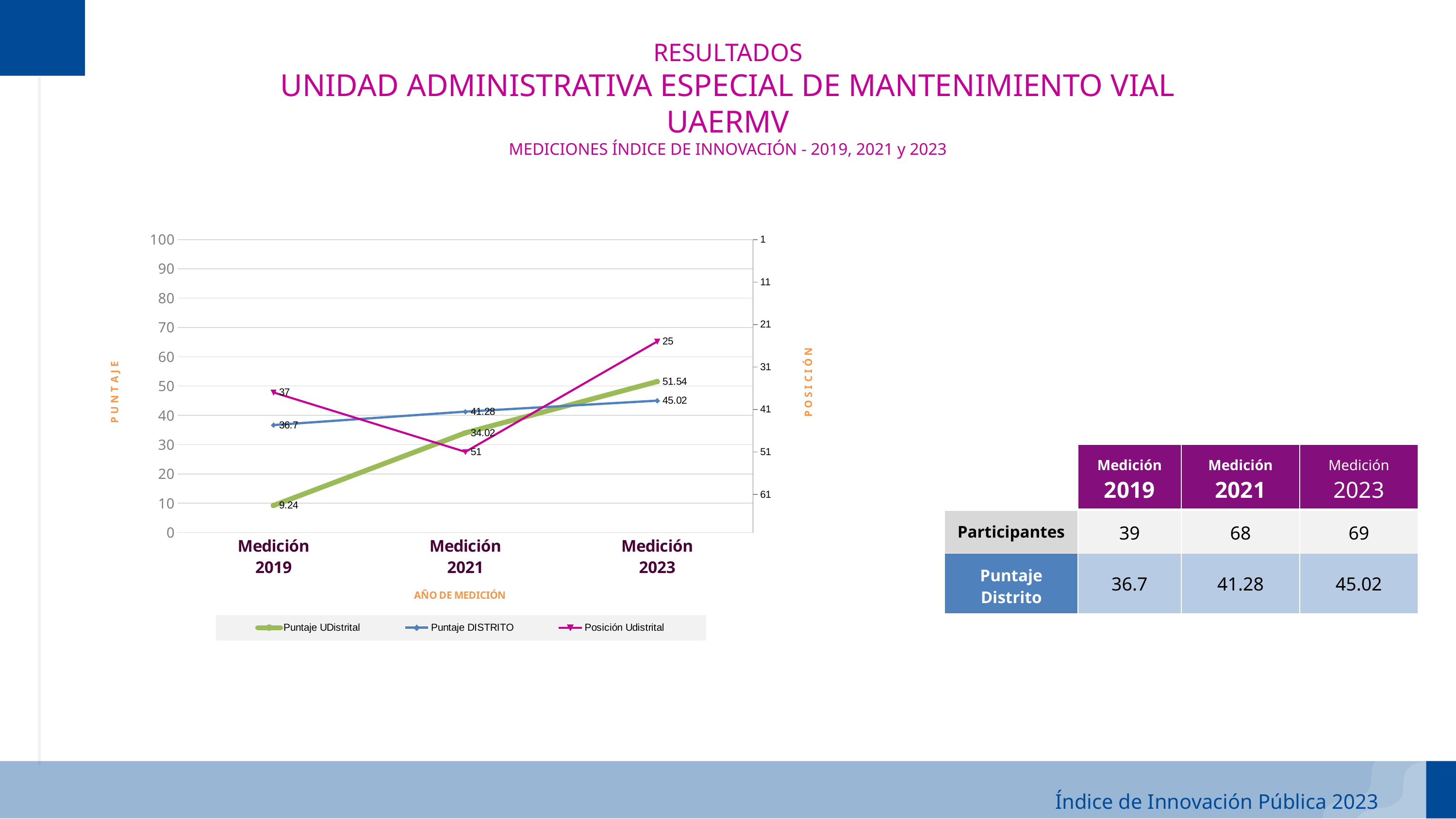
What is the Puntaje UDistrital value for Medición 2019? 9.24 Does Puntaje UDistrital rise or fall from Medición 2019 to Medición 2023? rise What type of chart is shown on the slide? line chart What is the Puntaje DISTRITO value for Medición 2021? 41.28 In which measurement year is Puntaje UDistrital highest? Medición 2023 How many measurement years are plotted on the x axis of the chart? 3 How many series does the chart legend list? 3 In which measurement year is Puntaje DISTRITO lowest? Medición 2019 What is the difference between Puntaje UDistrital and Puntaje DISTRITO for Medición 2023? 6.52 What is the Puntaje UDistrital value for Medición 2023? 51.54 What is the Posición Udistrital value for Medición 2021? 51 For Medición 2021, which is larger: Puntaje UDistrital or Puntaje DISTRITO? Puntaje DISTRITO